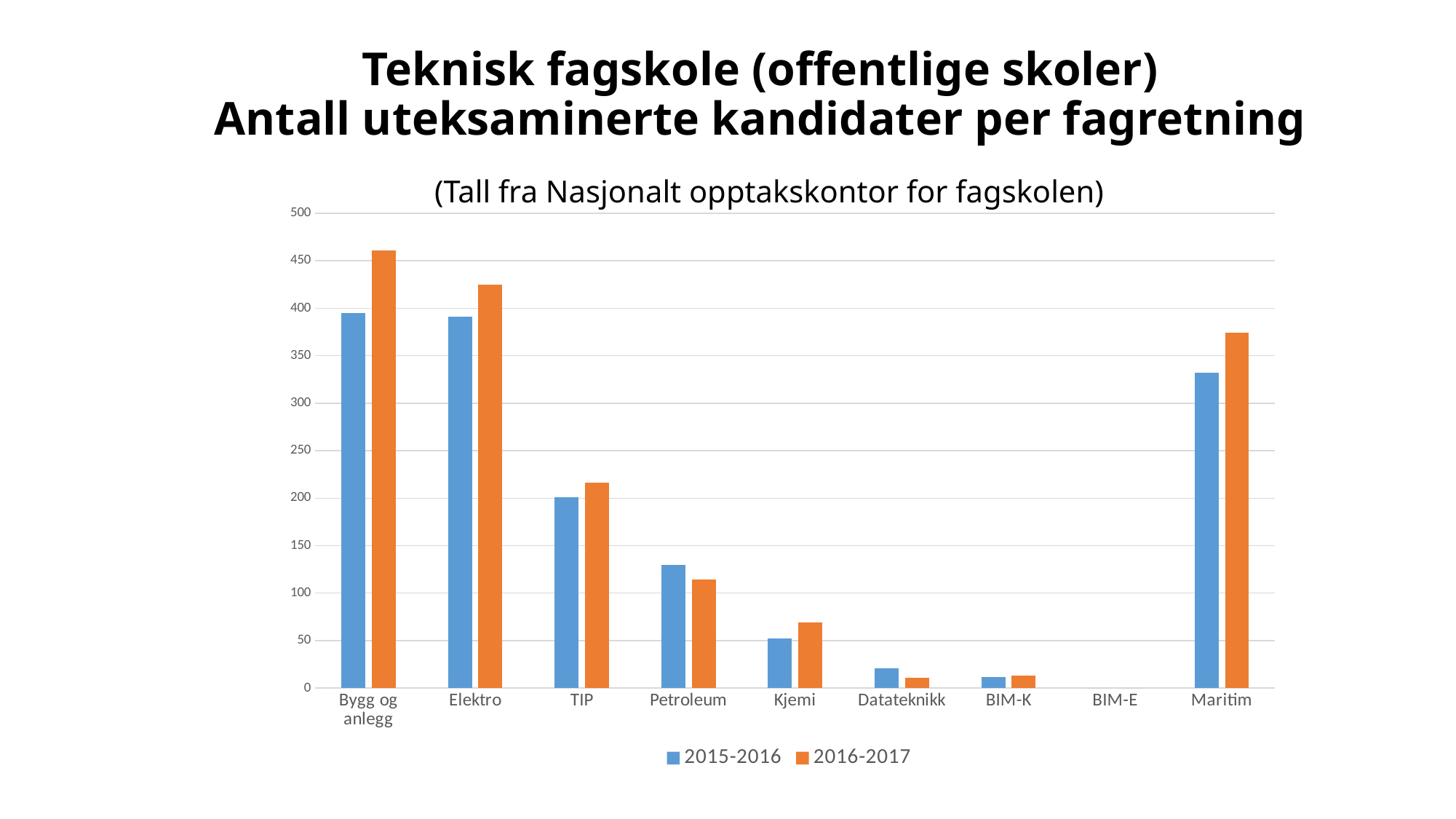
Is the 2016-2017 value for Bygg og anlegg greater or less than 450? greater For Petroleum, which year has the larger value, 2015-2016 or 2016-2017? 2015-2016 Is the 2016-2017 value for Elektro greater or less than 400? greater How many series does the legend list? 2 Which colour represents the 2016-2017 series in the legend? orange What kind of chart is shown on the slide? bar chart Which category has the highest value for 2016-2017? Bygg og anlegg Is the 2015-2016 value for Maritim greater or less than 350? less How many categories (fagretninger) are shown on the x axis? 9 For Maritim, which year has the larger value, 2015-2016 or 2016-2017? 2016-2017 Which category shows no visible bars for either year? BIM-E